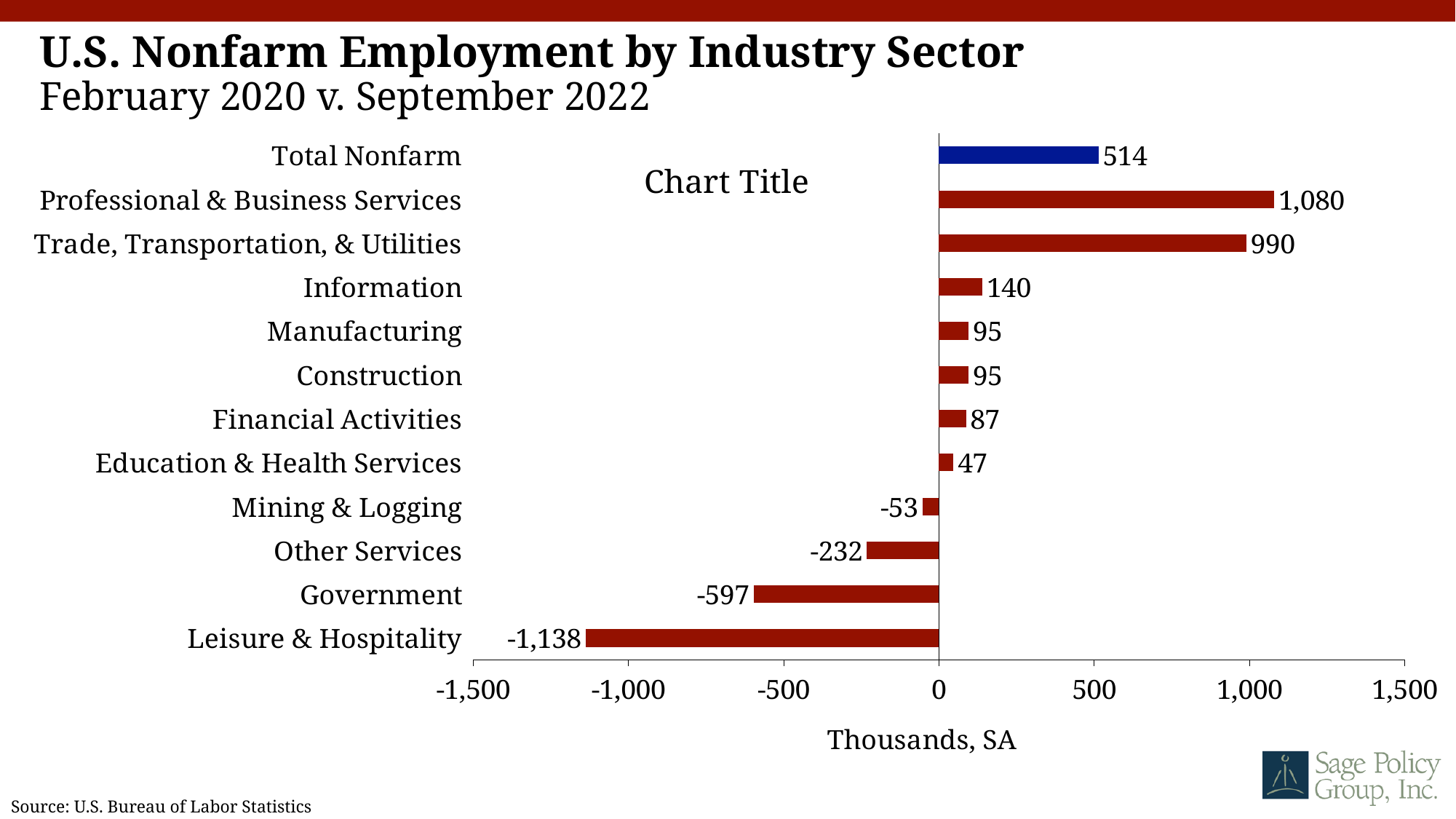
Which category has the lowest value? Leisure & Hospitality What kind of chart is shown on the slide? Bar chart Which is larger, the value for Information or the value for Financial Activities? Information What is the value for Government? -597 Which industry sector has the highest value? Professional & Business Services What is the x-axis label of the chart? Thousands, SA How many categories are shown on the chart? 12 What is the value for Professional & Business Services? 1,080 What is the value for Total Nonfarm? 514 Is the value for Other Services greater or less than -500? greater What is the value for Leisure & Hospitality? -1,138 What is the difference between the values for Professional & Business Services and Trade, Transportation, & Utilities? 90